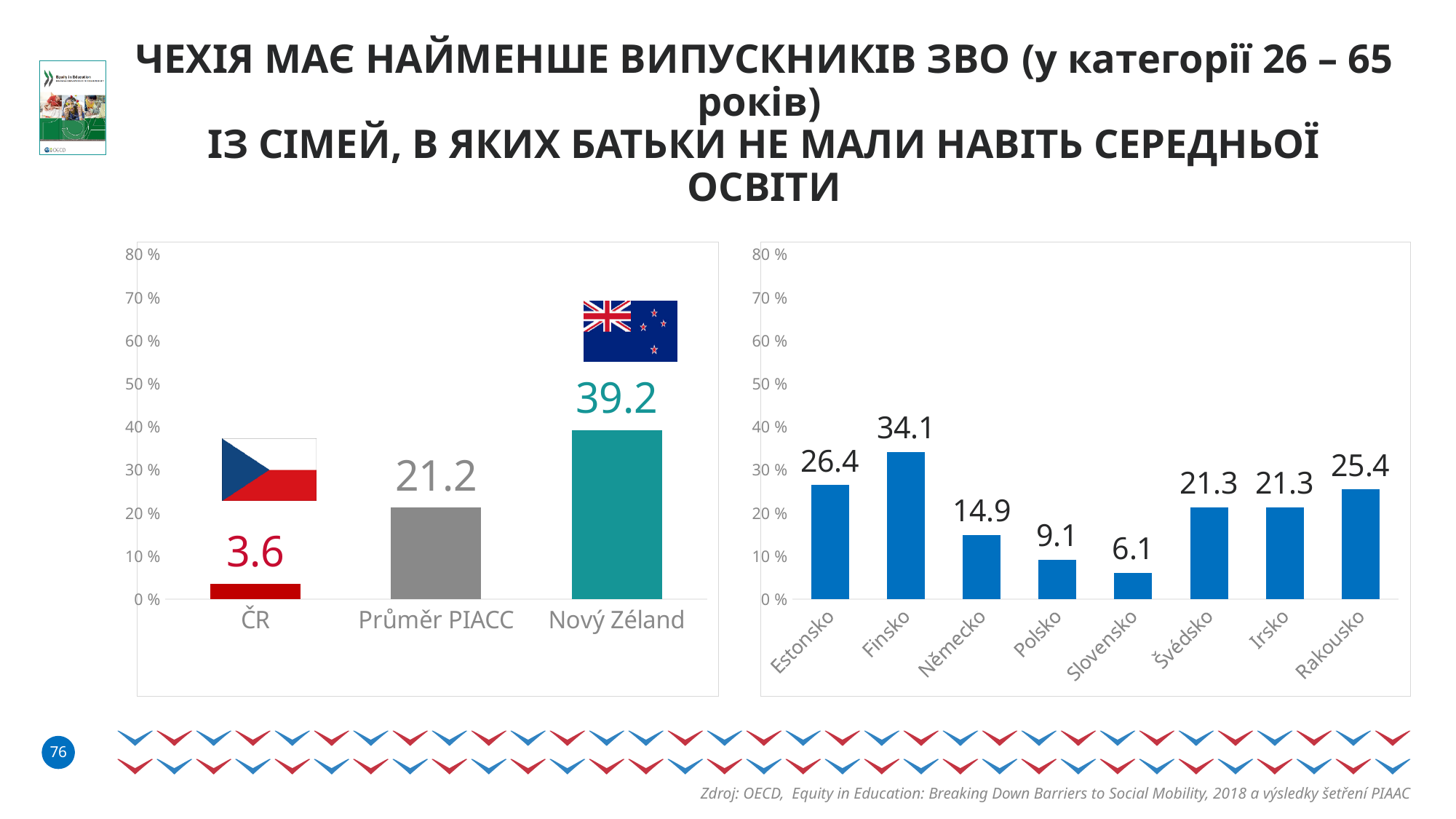
In the left chart, what is the difference between the values for Nový Zéland and ČR? 35.6 In the left chart, what is the value for Nový Zéland? 39.2 In the right chart, which country has the lowest value? Slovensko In the left chart, what is the value for ČR? 3.6 What kind of chart is the right chart? Bar chart In the left chart, what is the value for Průměr PIACC? 21.2 In the right chart, which is larger, the value for Estonsko or the value for Rakousko? Estonsko In the right chart, which country has the highest value? Finsko In the left chart, which category has the lowest value? ČR In the right chart, how many countries are shown? 8 In the right chart, what is the value for Slovensko? 6.1 In the right chart, what is the value for Finsko? 34.1